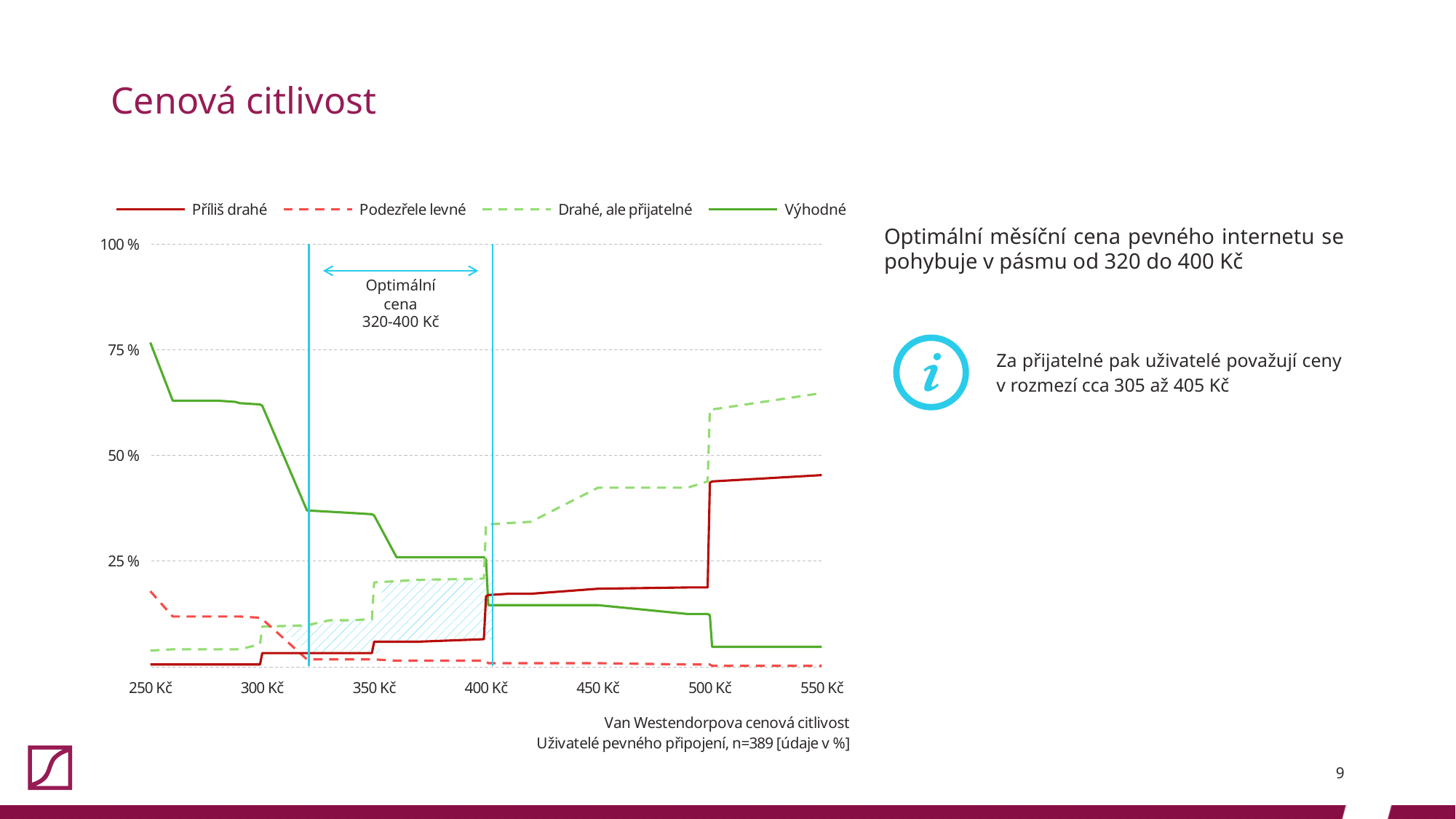
Is the value for 'Drahé, ale přijatelné' at 550 Kč greater or less than 50 %? greater Is the value for 'Podezřele levné' at 550 Kč greater or less than 25 %? less At 550 Kč, which series has the higher value: 'Příliš drahé' or 'Výhodné'? Příliš drahé How many series does the chart legend list? 4 Is the value for 'Příliš drahé' at 550 Kč greater or less than 50 %? less Does the 'Výhodné' line rise or fall as the price increases from 250 Kč to 550 Kč? fall Does the 'Příliš drahé' line rise or fall as the price increases from 250 Kč to 550 Kč? rise At 250 Kč, which series has the higher value: 'Výhodné' or 'Podezřele levné'? Výhodné What price range is marked on the chart as the 'Optimální cena'? 320-400 Kč What kind of chart is shown on the slide? line chart How many price ticks are labelled on the x axis of the chart? 7